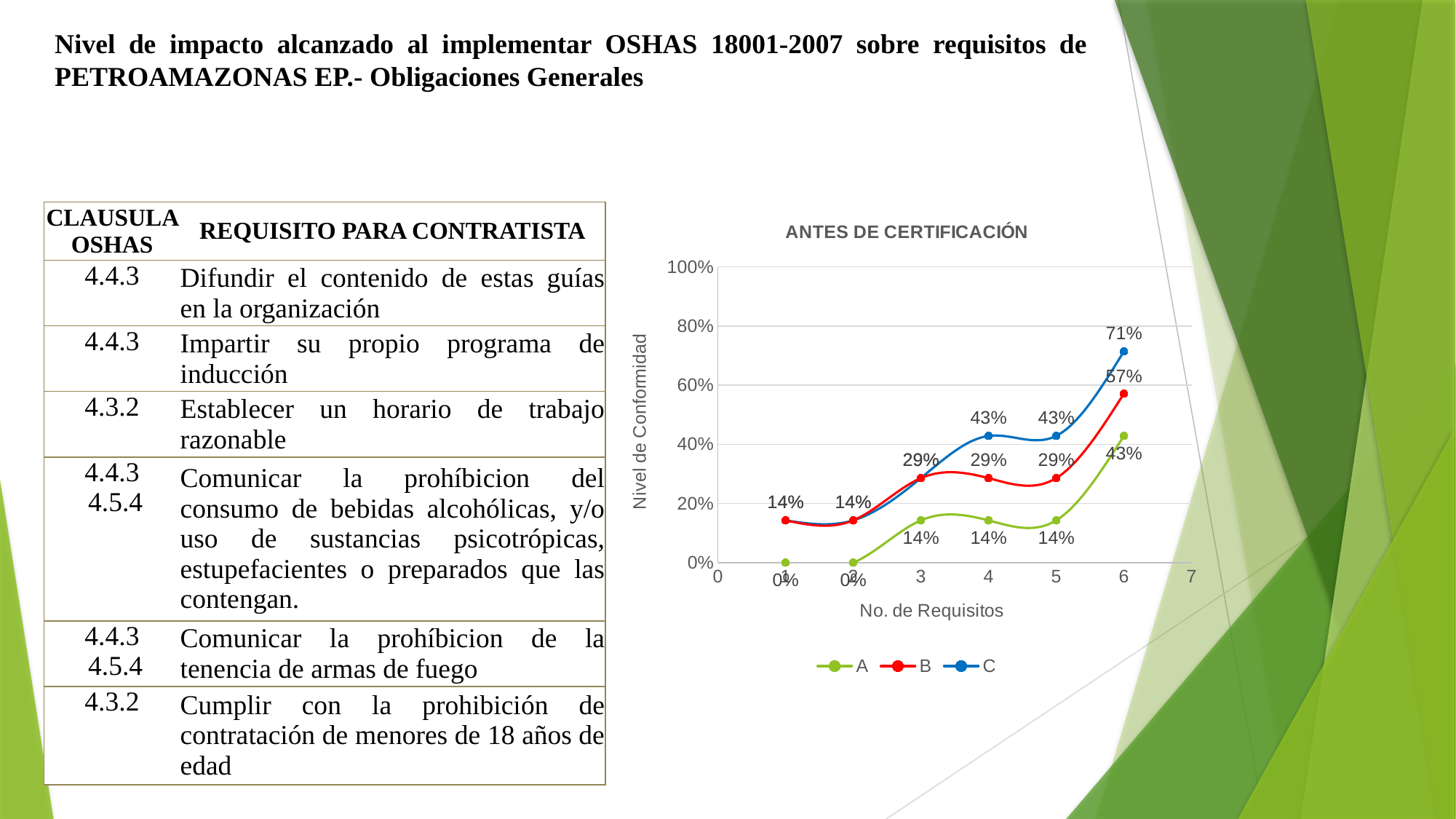
Does series B generally rise or fall as the number of requisitos increases from 1 to 6? rise How many series does the legend of the chart list? 3 What is the value of series B at requisito 6? 57% What is the value of series A at requisito 6? 43% What is the difference between series C and series B at requisito 6? 14% What is the value of series A at requisito 1? 0% What is the value of series C at requisito 4? 43% What kind of chart is shown on the slide? line chart At requisito 5, which series has the larger value, A or B? B What is the value of series C at requisito 6? 71% At which requisito number does series C reach its highest value? 6 What is the title of the chart? ANTES DE CERTIFICACIÓN